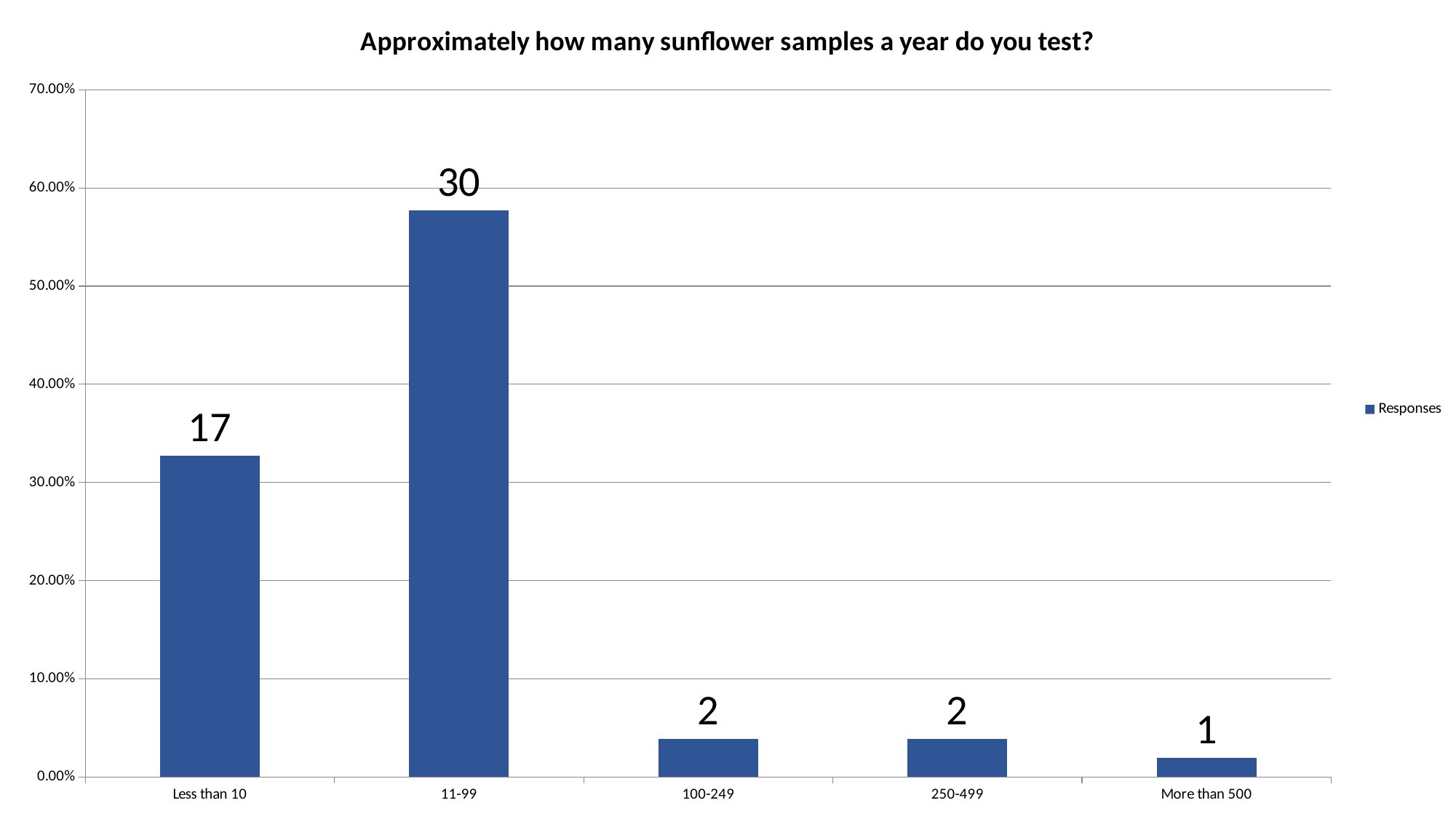
What data label is shown on the bar for 250-499? 2 Which category has the lowest bar? More than 500 What is the difference between the data labels for 11-99 and Less than 10? 13 Which is larger, the bar for Less than 10 or the bar for 100-249? Less than 10 What data label is shown on the bar for 11-99? 30 What kind of chart is shown on the slide? Bar chart What data label is shown on the bar for More than 500? 1 What data label is shown on the bar for Less than 10? 17 How many categories are shown on the x axis? 5 Is the bar for Less than 10 greater or less than 30.00% on the axis? greater Is the bar for 11-99 greater or less than 60.00% on the axis? less Which category has the highest bar? 11-99